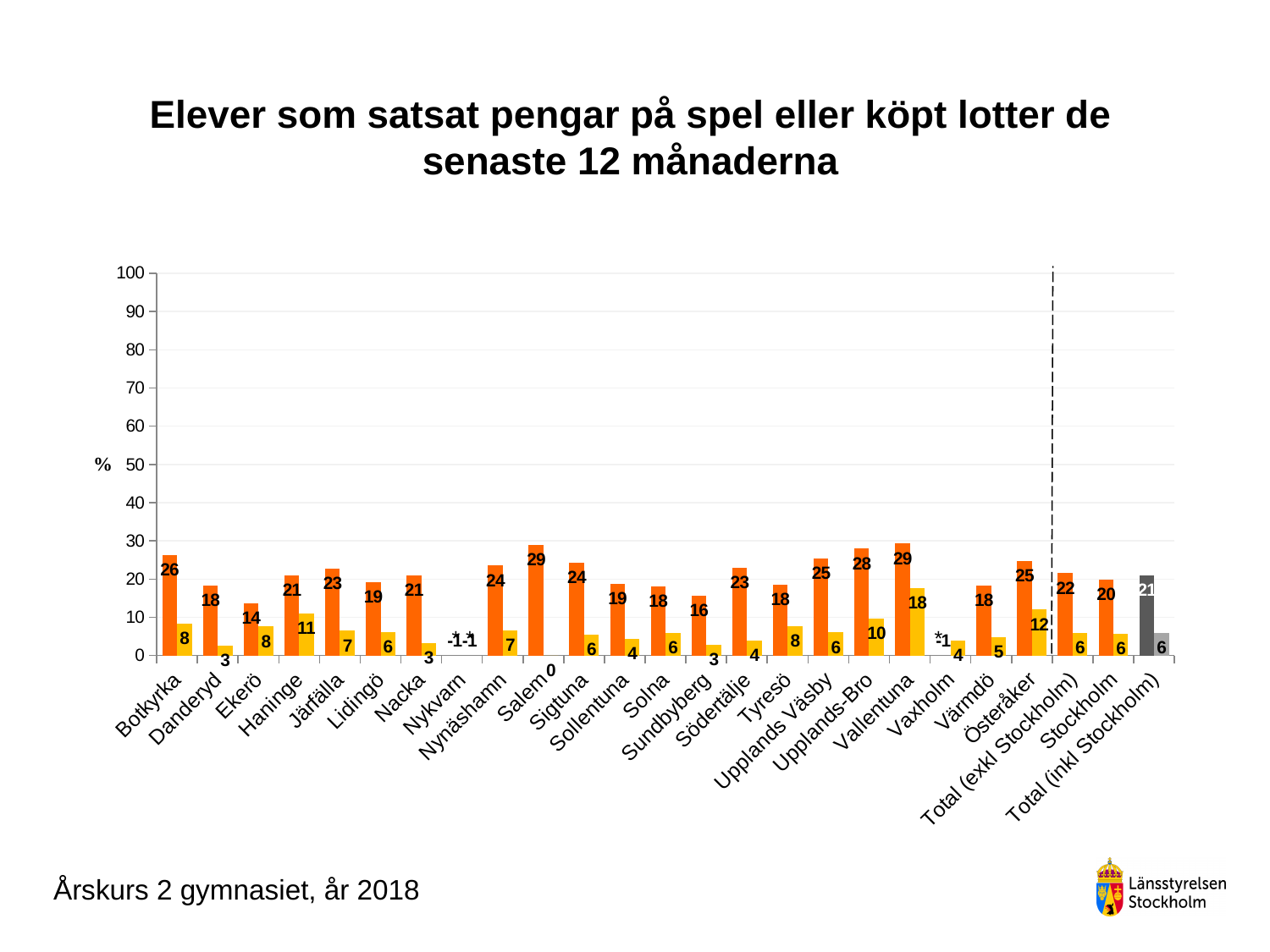
What is the value of the orange bar for Botkyrka? 26 What is the difference between the orange and yellow bars for Botkyrka? 18 Is the orange bar value for Vallentuna greater or less than 20? greater What is the title of the chart? Elever som satsat pengar på spel eller köpt lotter de senaste 12 månaderna What kind of chart is shown on the slide? bar chart What is the value shown for Total (inkl Stockholm) on the taller (grey) bar? 21 Which category has the highest yellow bar? Vallentuna What is the value of the orange bar for Upplands-Bro? 28 What is the value of the yellow bar for Haninge? 11 Which has the larger orange bar, Upplands-Bro or Österåker? Upplands-Bro What is the label on the vertical axis? %